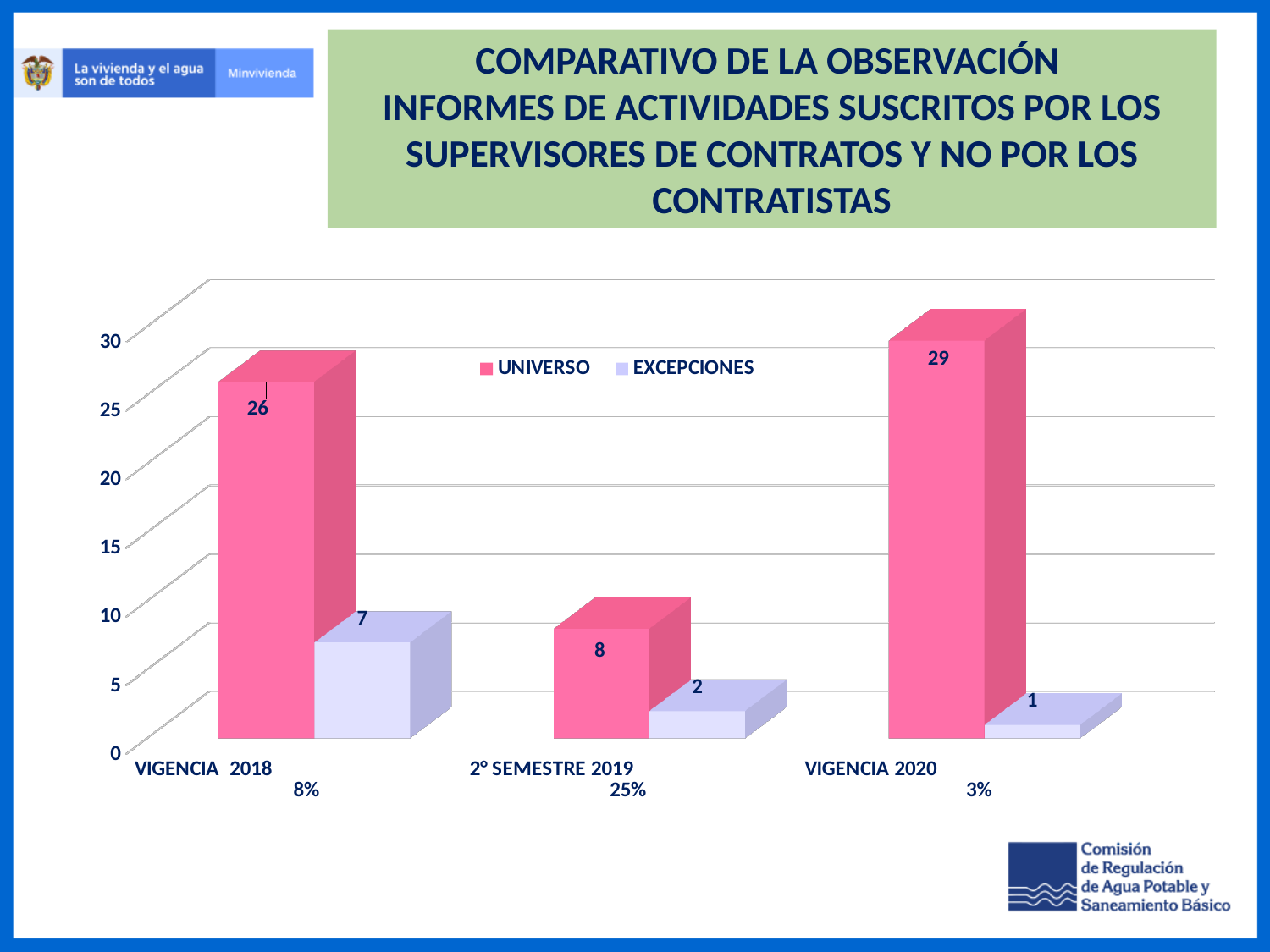
What percentage is printed below the 2° SEMESTRE 2019 category? 25% What is the EXCEPCIONES value for 2° SEMESTRE 2019? 2 What is the UNIVERSO value for VIGENCIA 2018? 26 How many series does the legend list? 2 What kind of chart is shown on the slide? Bar chart How many categories are shown on the x axis? 3 Which category has the highest UNIVERSO value? VIGENCIA 2020 Which is larger, the EXCEPCIONES value for VIGENCIA 2018 or for 2° SEMESTRE 2019? VIGENCIA 2018 What is the UNIVERSO value for VIGENCIA 2020? 29 What is the EXCEPCIONES value for VIGENCIA 2018? 7 What is the difference between the UNIVERSO values for VIGENCIA 2020 and 2° SEMESTRE 2019? 21 Which category has the lowest EXCEPCIONES value? VIGENCIA 2020